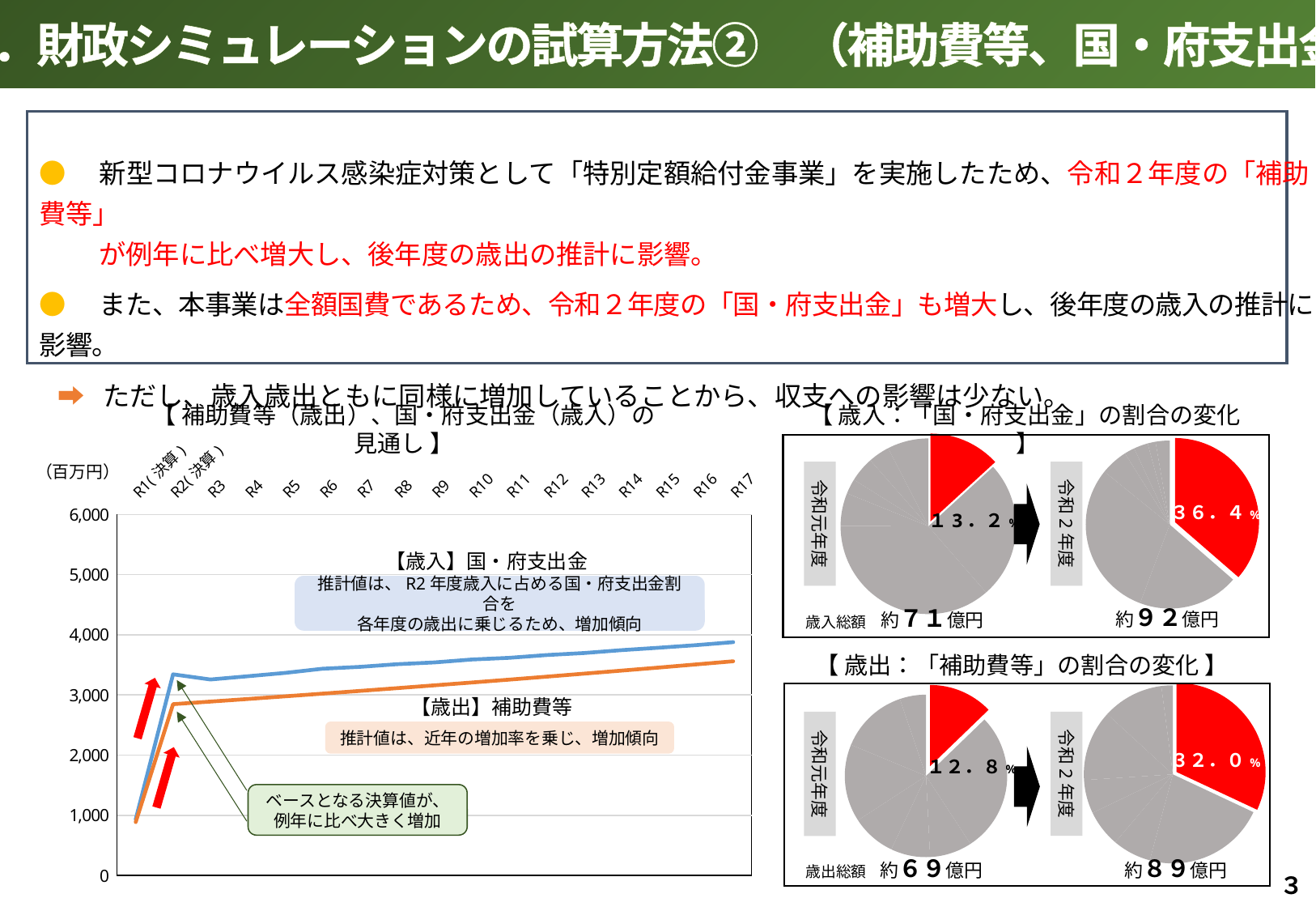
In the left line chart, at R17 which line is higher, 【歳入】国・府支出金 or 【歳出】補助費等? 【歳入】国・府支出金 In the pie charts titled 【歳出：「補助費等」の割合の変化】, by how many percentage points does the 補助費等 share increase from 令和元年度 (12.8%) to 令和2年度 (32.0%)? 19.2 percentage points In the left line chart, do the values of the 【歳入】国・府支出金 line rise or fall from R2 to R17? rise In the left line chart, is the value of 【歳入】国・府支出金 at R17 greater or less than 4,000? less In the left line chart, is the value of 【歳出】補助費等 at R17 greater or less than 3,000? greater In the pie charts titled 【歳出：「補助費等」の割合の変化】, what share does 補助費等 have in 令和2年度? 32.0% In the pie charts titled 【歳入：「国・府支出金」の割合の変化】, what share does 国・府支出金 have in 令和元年度? 13.2% In the left line chart, is the value of 【歳入】国・府支出金 at R2(決算) greater or less than 3,000? greater In the left line chart, how many fiscal years are shown on the x axis (R1 through R17)? 17 What kind of chart is the left chart titled 【補助費等（歳出）、国・府支出金（歳入）の見通し】? line chart In the left line chart, what unit is shown for the y axis? 百万円 In the pie charts titled 【歳入：「国・府支出金」の割合の変化】, what share does 国・府支出金 have in 令和2年度? 36.4%